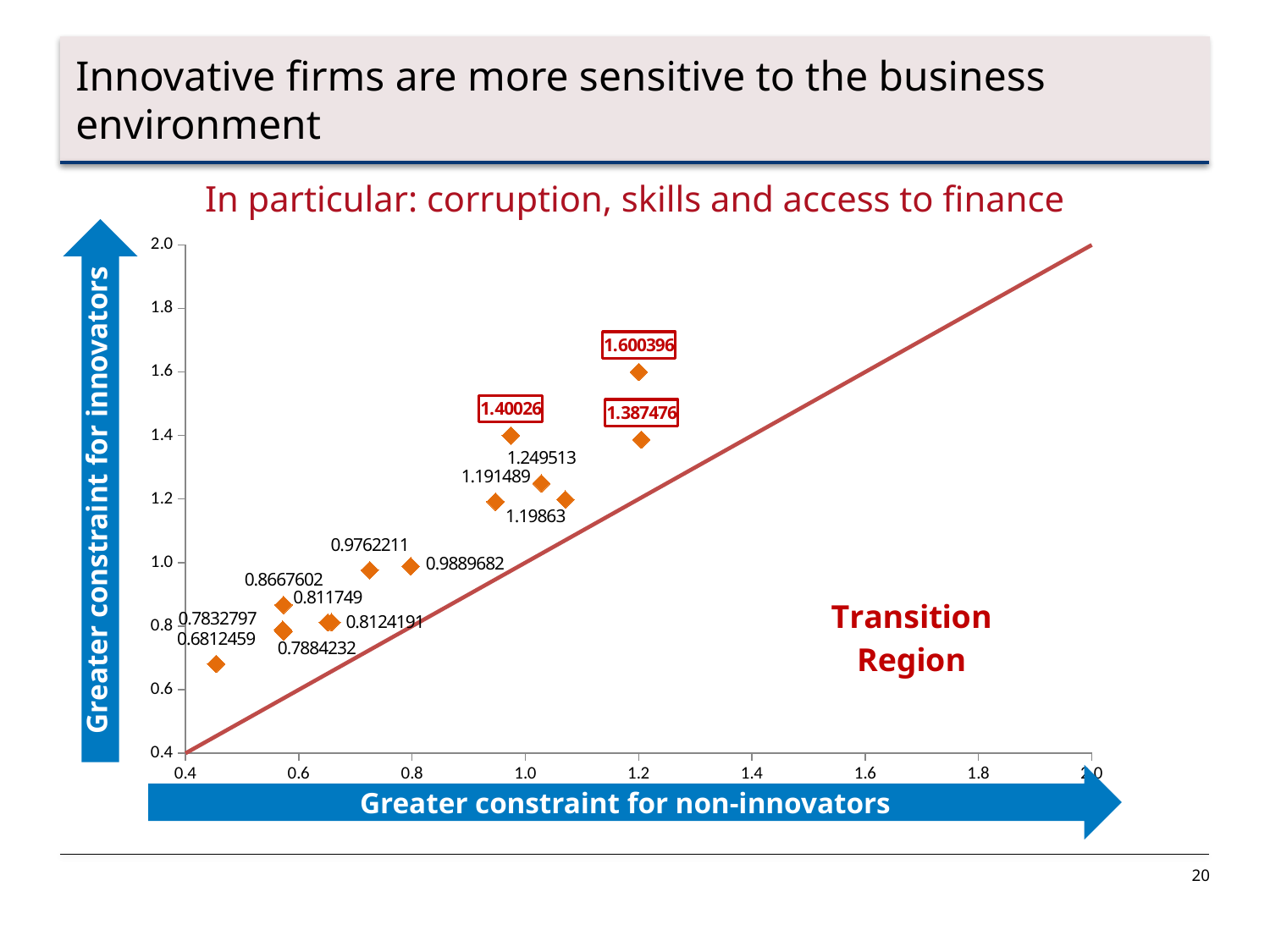
Which of the two boxed values is larger, 1.40026 or 1.387476? 1.40026 What is the highest data label value shown on the chart? 1.600396 What is the label on the vertical axis of the chart? Greater constraint for innovators Is the value of the lowest point on the chart greater or less than 0.8? less How many data labels on the chart are highlighted with a red box? 3 What is the difference between the highest labeled value (1.600396) and the lowest labeled value (0.6812459)? 0.9191501 Do the plotted points generally rise or fall as you move from left to right along the x axis? rise What kind of chart is shown on the slide? scatter chart What is the difference between the two boxed values 1.40026 and 1.387476? 0.012784 What is the lowest data label value shown on the chart? 0.6812459 What is the label on the horizontal axis of the chart? Greater constraint for non-innovators Is the value of the highest point on the chart greater or less than 1.4? greater